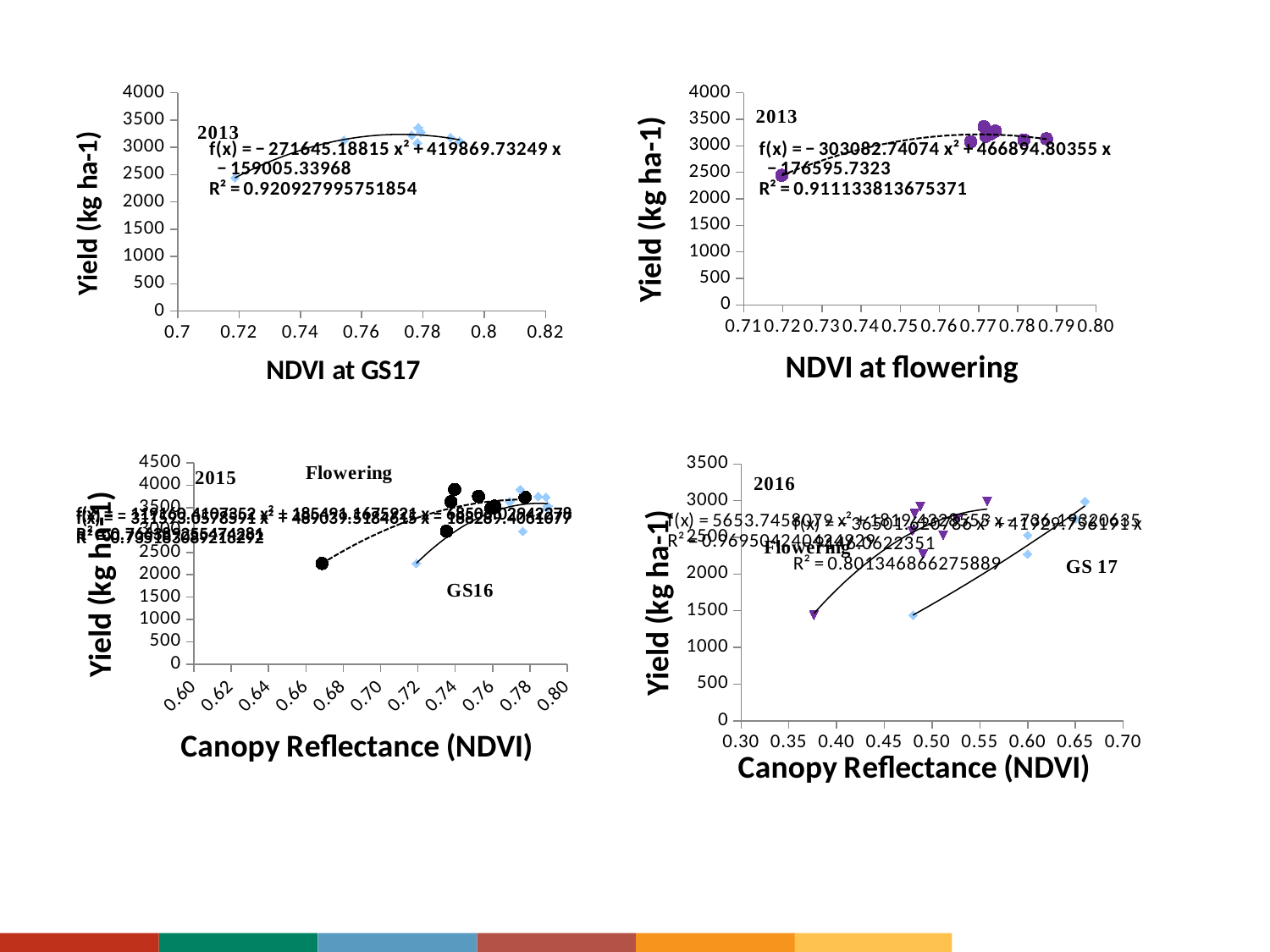
In the top-right chart (NDVI at flowering), is the yield of the lowest point (near NDVI 0.72) greater or less than 3000? less What is the x-axis title of the top-right chart labelled 2013? NDVI at flowering What kind of chart is the top-left chart labelled 2013 with x-axis NDVI at GS17? Scatter chart What is the y-axis title shared by the charts on the slide? Yield (kg ha-1) In the bottom-left chart labelled 2015, is the yield of the lowest Flowering point (near NDVI 0.67) greater or less than 2500? less In the top-left chart (NDVI at GS17), is the yield of the lowest point (near NDVI 0.72) greater or less than 3000? less In the top-left chart (NDVI at GS17), what is the R² value printed on the chart? 0.920927995751854 How many data series are plotted in the bottom-left chart labelled 2015? 2 In the top-right chart (NDVI at flowering), what is the R² value printed on the chart? 0.911133813675371 In the bottom-right chart labelled 2016, does yield rise or fall as canopy reflectance (NDVI) increases? rise In the bottom-right chart labelled 2016, what is the R² value printed for the GS 17 series? 0.801346866275889